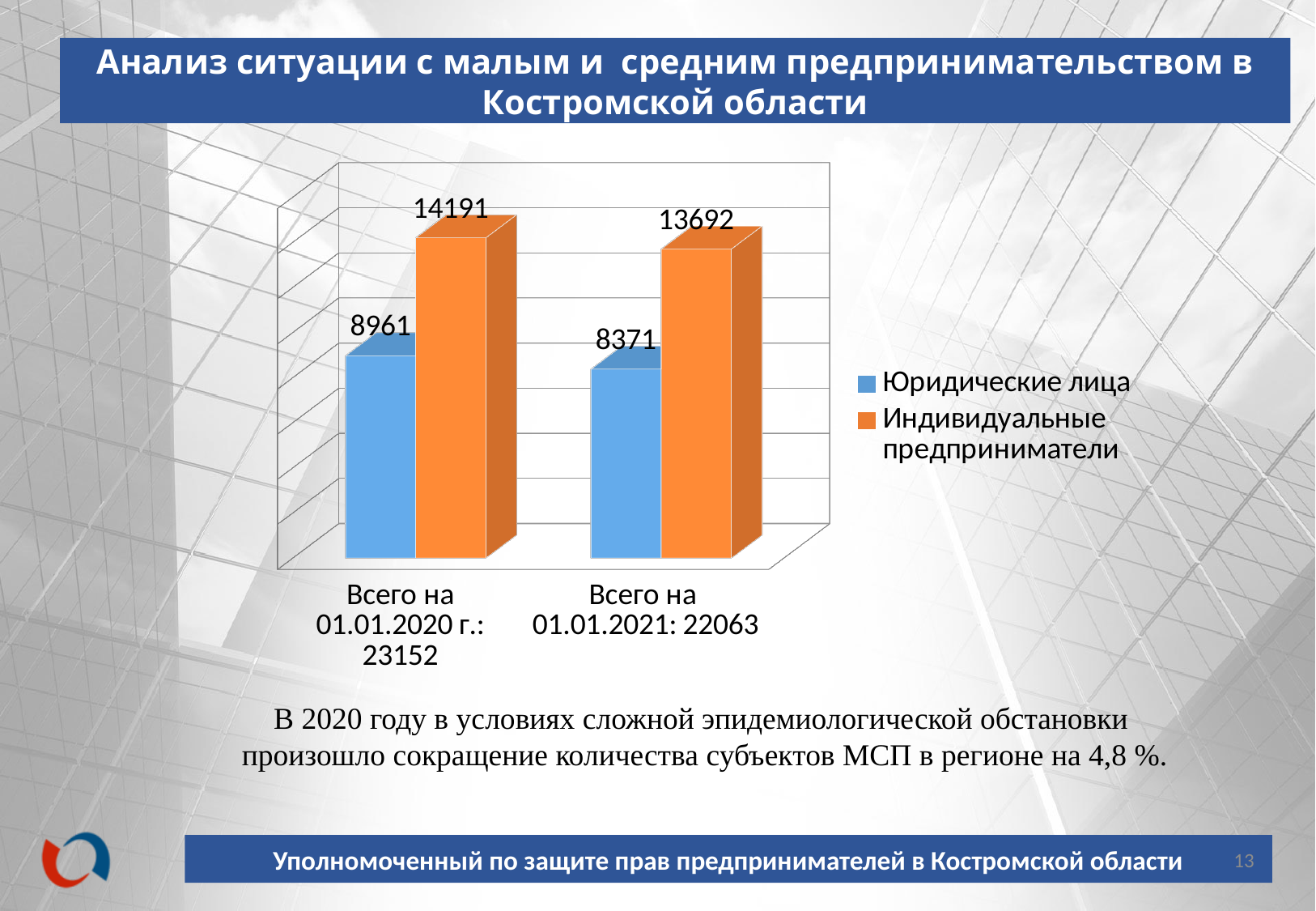
Do the values for Индивидуальные предприниматели rise or fall from 01.01.2020 to 01.01.2021? Fall How many series does the legend list? 2 What is the value for Индивидуальные предприниматели on 01.01.2021? 13692 Which bar has the lowest value on the chart? Юридические лица on 01.01.2021 Which series has the highest value on the chart? Индивидуальные предприниматели What is the value for Юридические лица on 01.01.2020? 8961 What is the difference between Юридические лица on 01.01.2020 and on 01.01.2021? 590 What is the value for Индивидуальные предприниматели on 01.01.2020? 14191 Which is larger: Юридические лица on 01.01.2020 or Юридические лица on 01.01.2021? Юридические лица on 01.01.2020 What is the value for Юридические лица on 01.01.2021? 8371 What is the difference between Индивидуальные предприниматели on 01.01.2020 and on 01.01.2021? 499 What kind of chart is shown on the slide? Bar chart